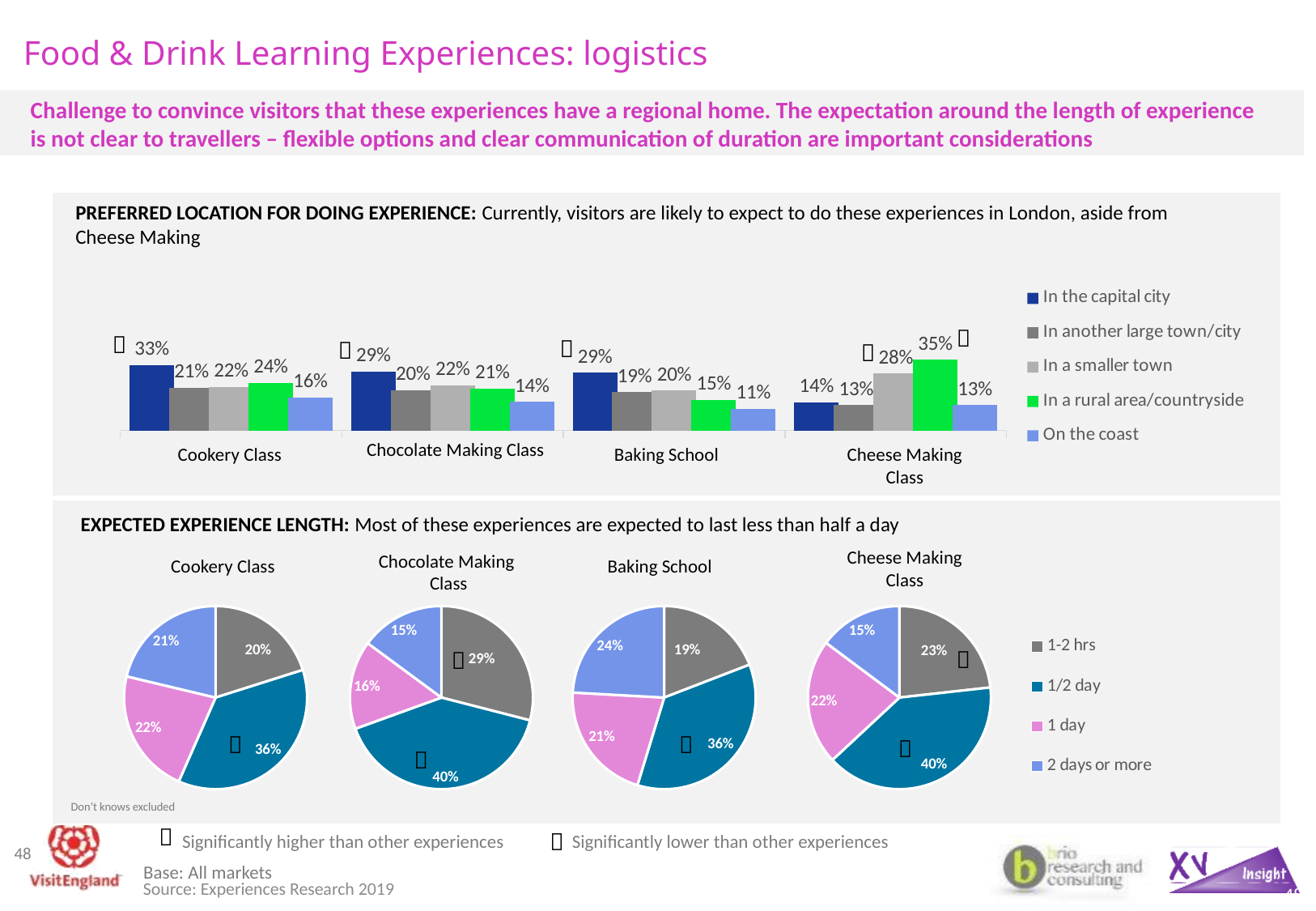
In the preferred location bar chart, which location has the lowest value for Baking School? On the coast How many pie charts are shown in the expected experience length section? 4 What type of chart is used for the preferred location for doing experience? Bar chart In the Baking School expected experience length pie chart, what is the share for 2 days or more? 24% In the preferred location bar chart, what is the value for Cheese Making Class in a rural area/countryside? 35% In the preferred location bar chart, which is larger for Baking School: in a smaller town or in a rural area/countryside? In a smaller town In the Chocolate Making Class expected experience length pie chart, which category has the smallest share? 2 days or more How many series does the legend of the preferred location bar chart list? 5 In the preferred location bar chart, what percentage of visitors expect to do a Cookery Class in the capital city? 33% In the preferred location bar chart, which location has the highest value for Chocolate Making Class? In the capital city In the preferred location bar chart, what is the difference between the capital city value for Cookery Class and the capital city value for Cheese Making Class? 19 percentage points In the Cookery Class expected experience length pie chart, what share is 1/2 day? 36%